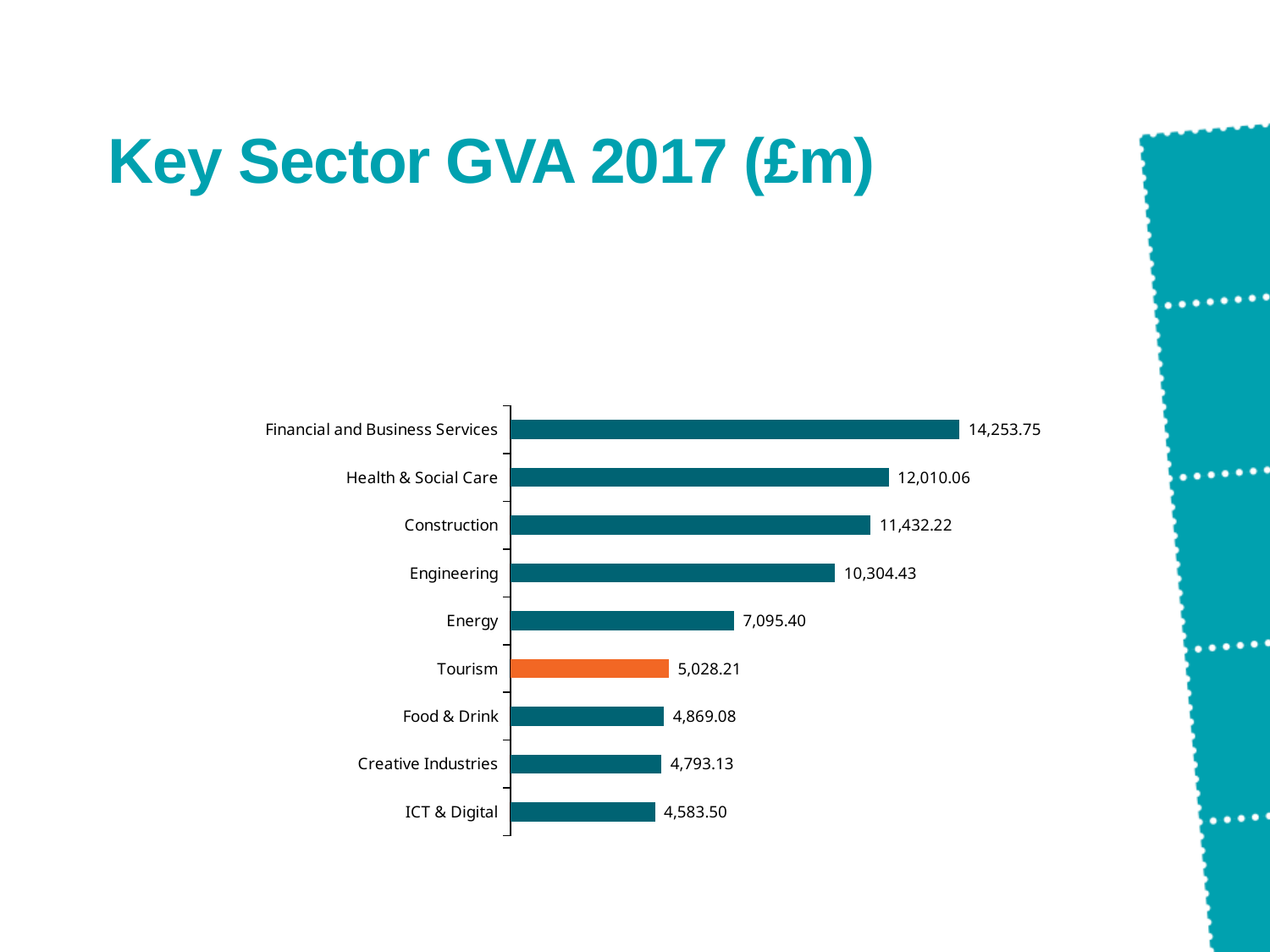
How many sectors are shown in the chart? 9 What is the GVA value for Tourism? 5,028.21 What is the GVA value for Food & Drink? 4,869.08 What is the difference between the GVA of Tourism and Energy? 2,067.19 Which has a larger GVA, Creative Industries or Food & Drink? Food & Drink What is the difference between the GVA of Health & Social Care and Construction? 577.84 Which sector's bar is highlighted in orange? Tourism Which sector has the lowest GVA? ICT & Digital Which sector has the highest GVA? Financial and Business Services What is the GVA value for Engineering? 10,304.43 Which has a larger GVA, Energy or Engineering? Engineering What type of chart is shown on the slide? Bar chart